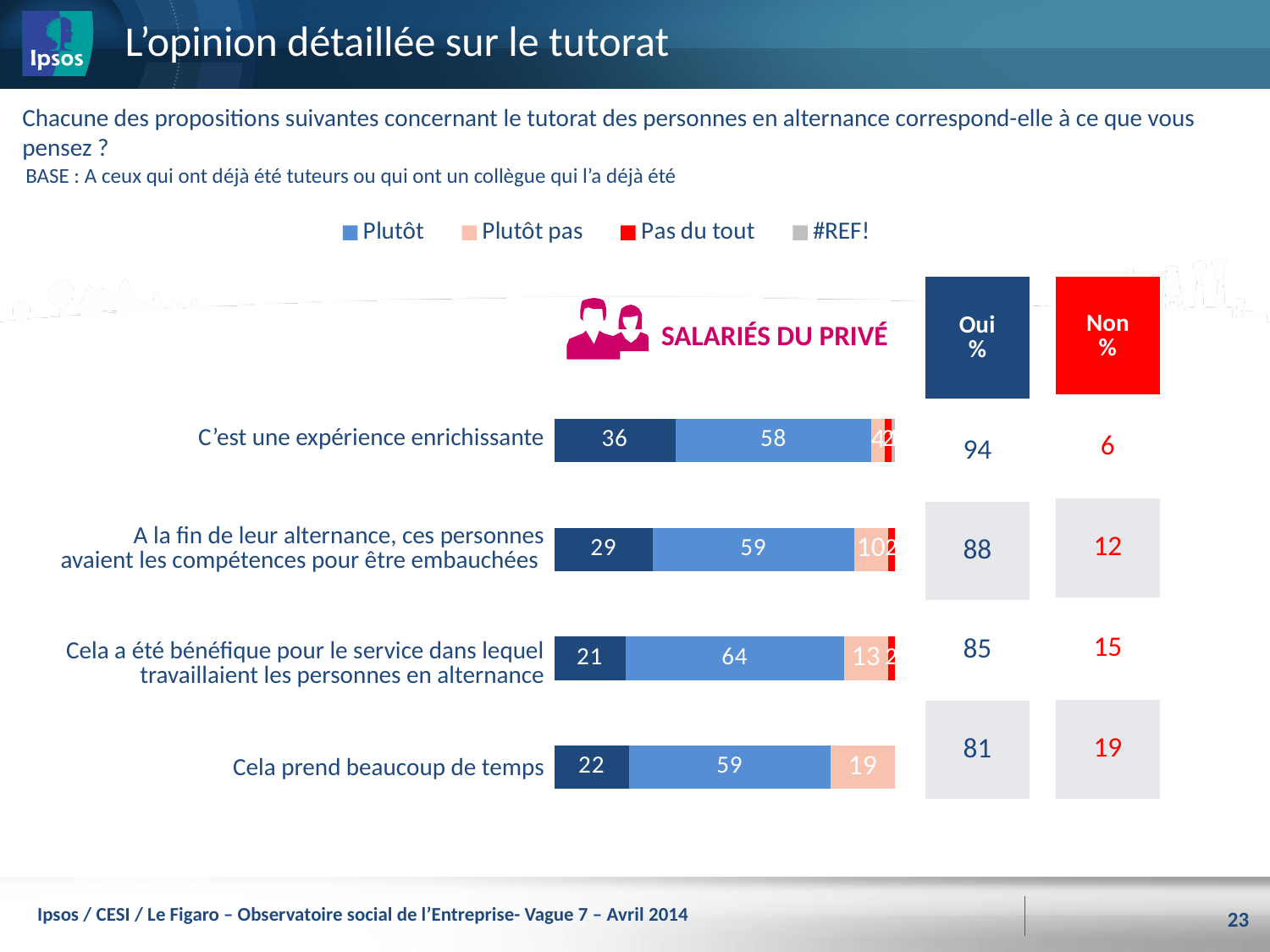
How many series does the chart legend list? 4 What is the value of the dark blue (first) segment for 'A la fin de leur alternance, ces personnes avaient les compétences pour être embauchées'? 29 Which proposition has the highest 'Plutôt' value? Cela a été bénéfique pour le service dans lequel travaillaient les personnes en alternance What is the 'Plutôt pas' value for 'Cela a été bénéfique pour le service dans lequel travaillaient les personnes en alternance'? 13 What kind of chart is shown on the slide? bar chart What is the 'Oui %' value shown for 'Cela prend beaucoup de temps'? 81 What is the 'Plutôt' value for 'C'est une expérience enrichissante'? 58 How many propositions (categories) are plotted in the chart? 4 What is the difference between the 'Plutôt' value (58) and the dark blue segment value (36) for 'C'est une expérience enrichissante'? 22 Which is larger: the 'Plutôt' value for 'Cela a été bénéfique pour le service...' or for 'C'est une expérience enrichissante'? Cela a été bénéfique pour le service dans lequel travaillaient les personnes en alternance What is the 'Plutôt pas' value for 'Cela prend beaucoup de temps'? 19 Which proposition has the lowest 'Plutôt pas' value? C'est une expérience enrichissante